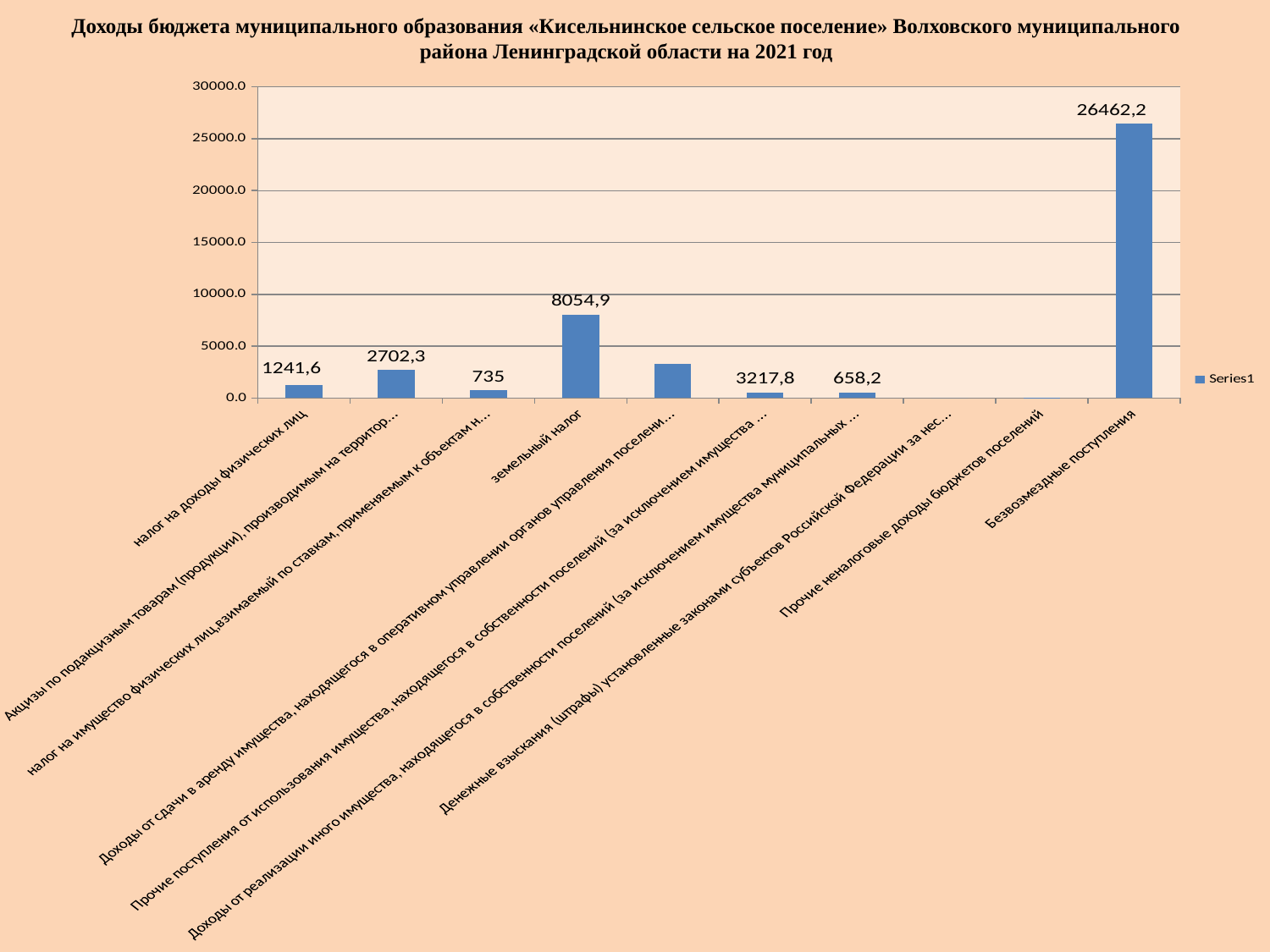
Which category has the highest value? Безвозмездные поступления What type of chart is shown on the slide? Bar chart What is the value for «земельный налог»? 8054,9 What is the name of the series shown in the legend? Series1 What is the difference between «Безвозмездные поступления» and «земельный налог»? 18407,3 How many series does the legend list? 1 Which is larger: «земельный налог» or «налог на доходы физических лиц»? земельный налог Is the value for «земельный налог» greater or less than 10000? less How many categories are shown on the x axis? 10 What is the value for «налог на доходы физических лиц»? 1241,6 What is the value for the category «Акцизы по подакцизным товарам (продукции), производимым на территор...»? 2702,3 What is the value for «Безвозмездные поступления»? 26462,2